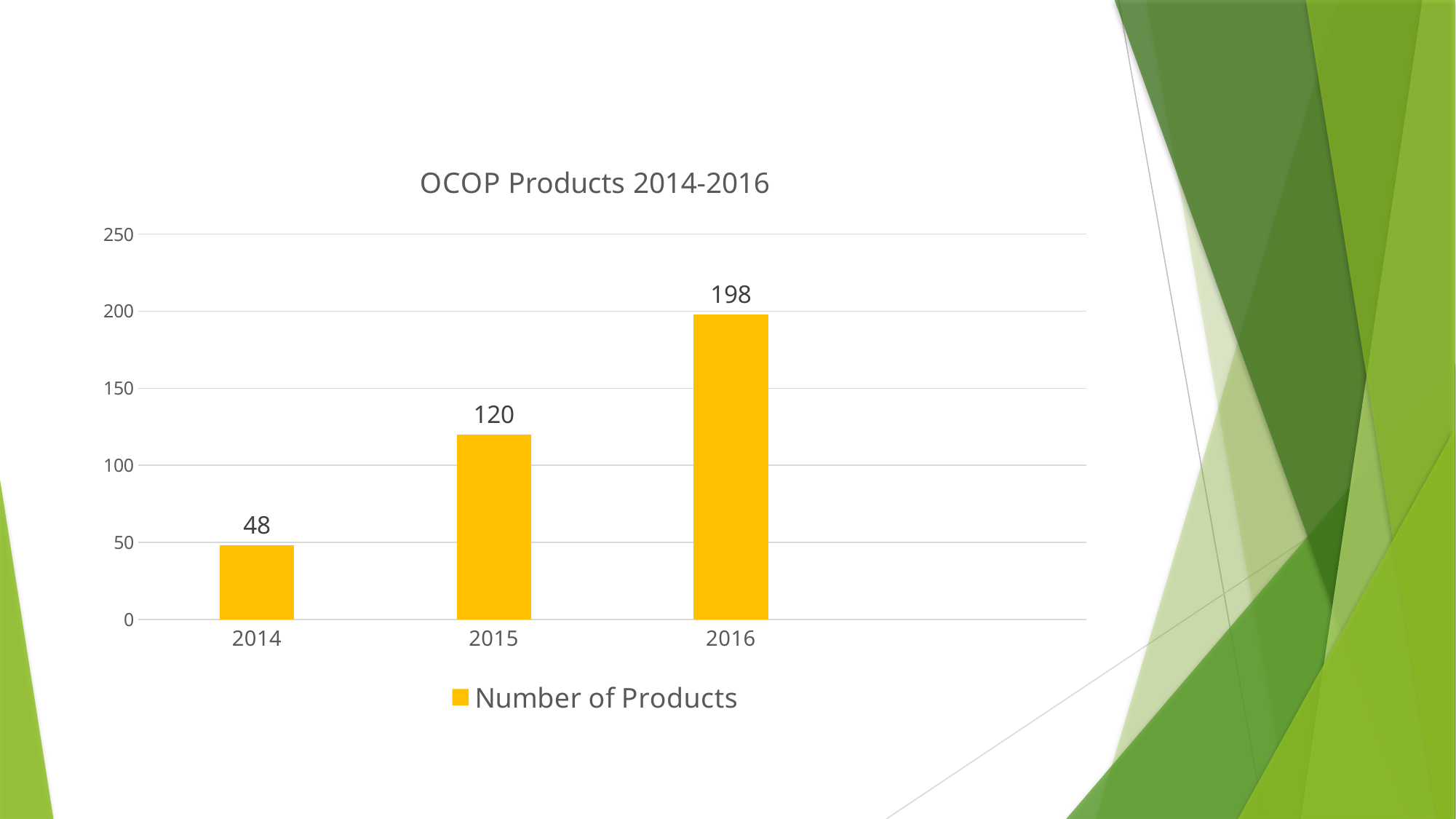
Which year has more products, 2014 or 2015? 2015 What is the number of products for 2014? 48 Which year has the lowest number of products? 2014 What is the number of products for 2015? 120 Which year has the highest number of products? 2016 What is the difference in the number of products between 2015 and 2014? 72 How many years are shown on the x axis? 3 What is the difference in the number of products between 2016 and 2015? 78 Do the values rise or fall from 2014 to 2016? Rise What is the number of products for 2016? 198 What kind of chart is shown on the slide? Bar chart Is the value for 2016 greater or less than 150? greater